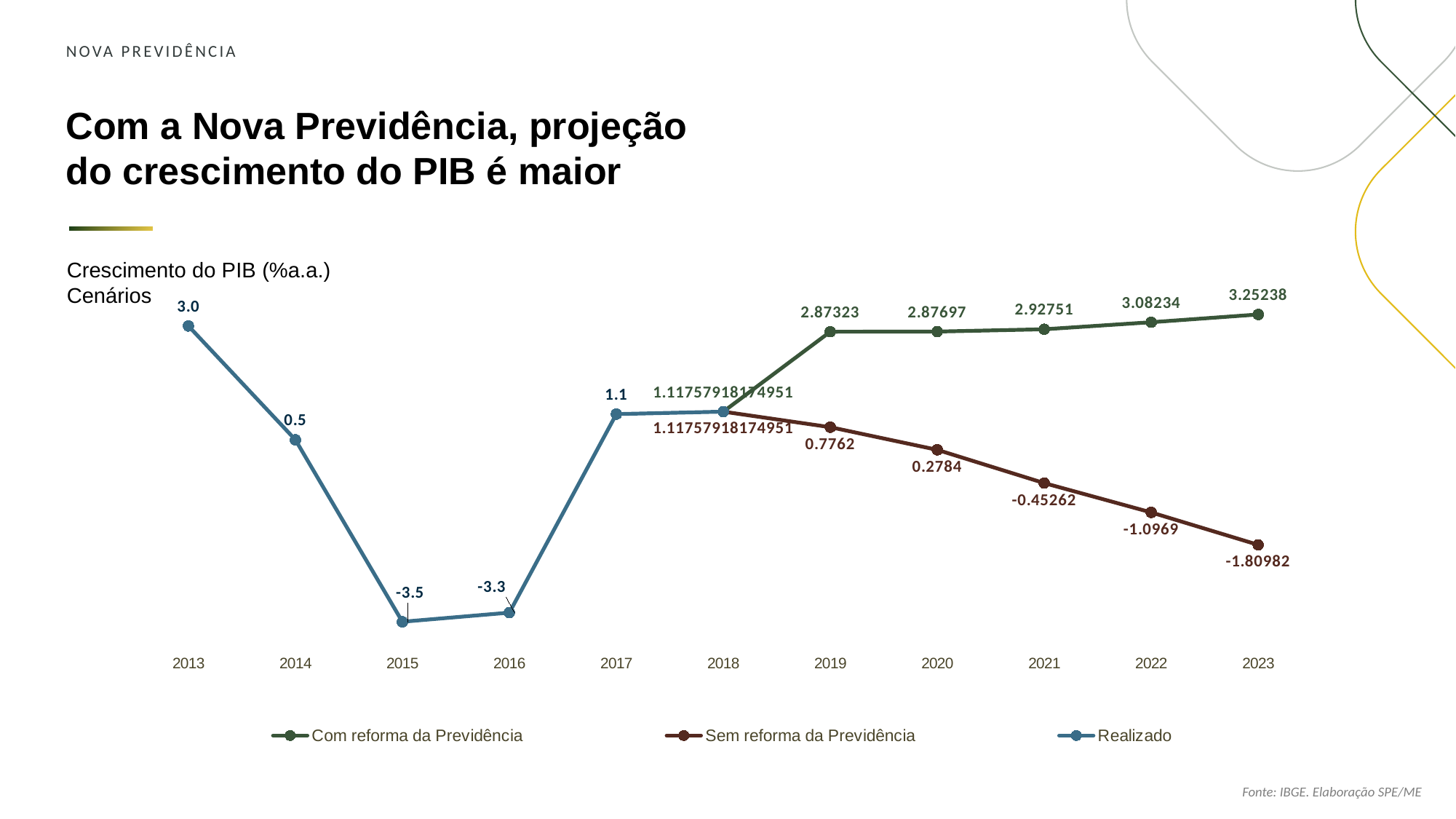
How many series does the legend list? 3 In which year does the Realizado series reach its lowest value? 2015 Which series has the larger value in 2022, Com reforma da Previdência or Sem reforma da Previdência? Com reforma da Previdência What is the value for Sem reforma da Previdência in 2019? 0.7762 How many years are shown on the x axis? 11 Does the Sem reforma da Previdência series rise or fall from 2018 to 2023? Fall What is the difference between the Realizado values for 2013 and 2014? 2.5 What is the value for Sem reforma da Previdência in 2021? -0.45262 In which year does the Com reforma da Previdência series reach its highest value? 2023 What is the value for the Realizado series in 2015? -3.5 What type of chart is shown on the slide? Line chart What is the value for Com reforma da Previdência in 2023? 3.25238